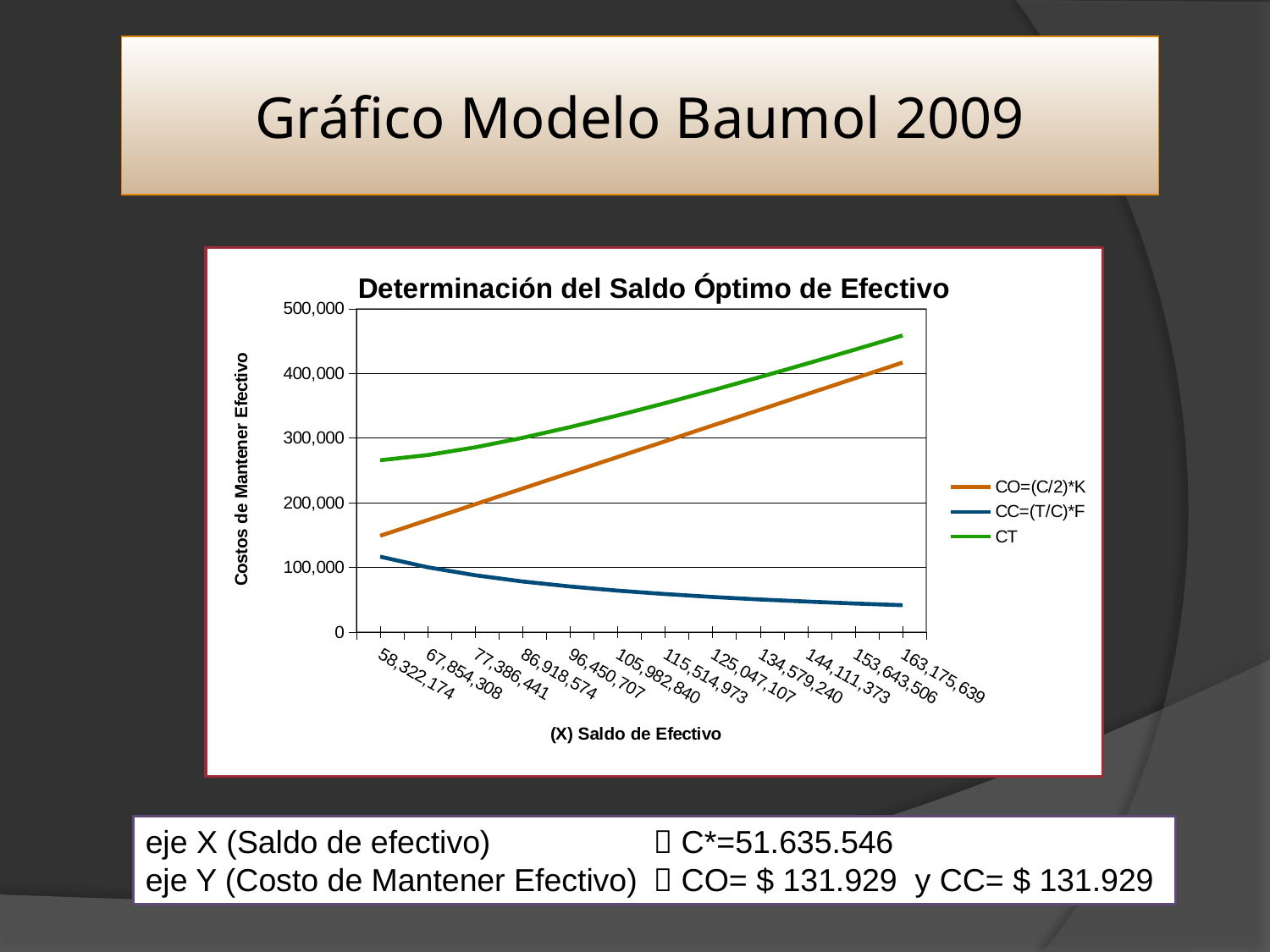
At 163,175,639, which is larger: CT or CO=(C/2)*K? CT Is the value of CT at 58,322,174 greater or less than 200,000? greater How many series does the chart legend list? 3 Is the value of CC=(T/C)*F at 163,175,639 greater or less than 100,000? less Which series has the highest values across the whole chart? CT Is the value of CO=(C/2)*K at 58,322,174 greater or less than 200,000? less How many categories are shown on the x axis of the chart? 12 What is the label of the y axis of the chart? Costos de Mantener Efectivo What is the title of the chart? Determinación del Saldo Óptimo de Efectivo What kind of chart is shown on the slide? line chart Does the CO=(C/2)*K line rise or fall as the x axis values increase? rise Does the CC=(T/C)*F line rise or fall as the x axis values increase? fall